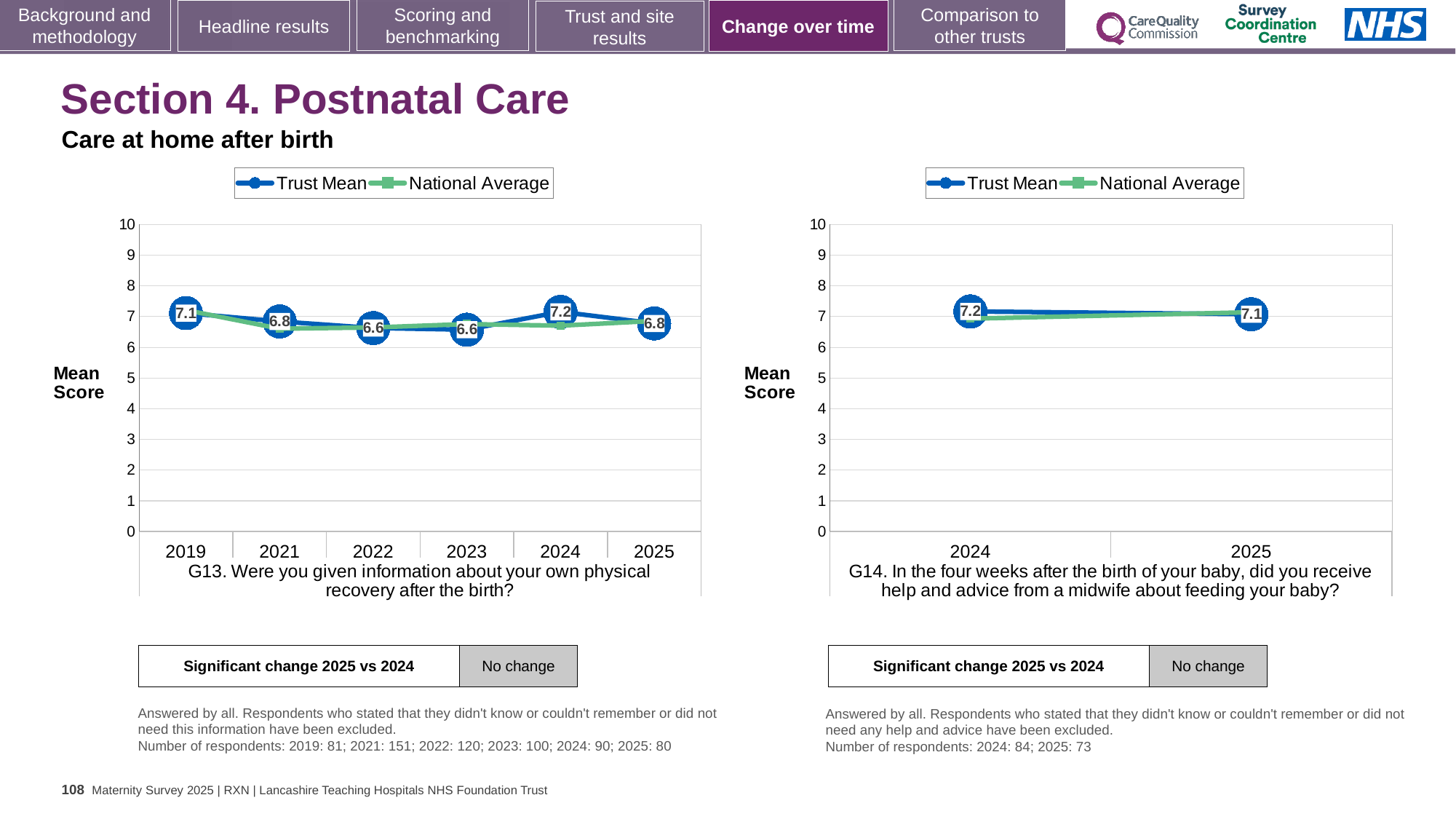
In the G13 chart on the left, which year has the highest Trust Mean score? 2024 In the G13 chart on the left, is the National Average value for 2019 greater or less than 5? greater In the G13 chart on the left, is the Trust Mean score higher in 2019 or in 2021? 2019 In the G14 chart on the right, what is the difference between the Trust Mean scores for 2024 and 2025? 0.1 In the G14 chart on the right, what is the Trust Mean score for 2025? 7.1 How many years are plotted on the x axis of the G13 chart on the left? 6 How many series does the legend of the G14 chart on the right list? 2 What type of chart is the G13 chart on the left? Line chart How many years are plotted on the x axis of the G14 chart on the right? 2 In the G13 chart on the left, what is the Trust Mean score for 2025? 6.8 In the G13 chart on the left, what is the difference between the Trust Mean scores for 2024 and 2025? 0.4 In the G13 chart on the left, what is the Trust Mean score for 2019? 7.1